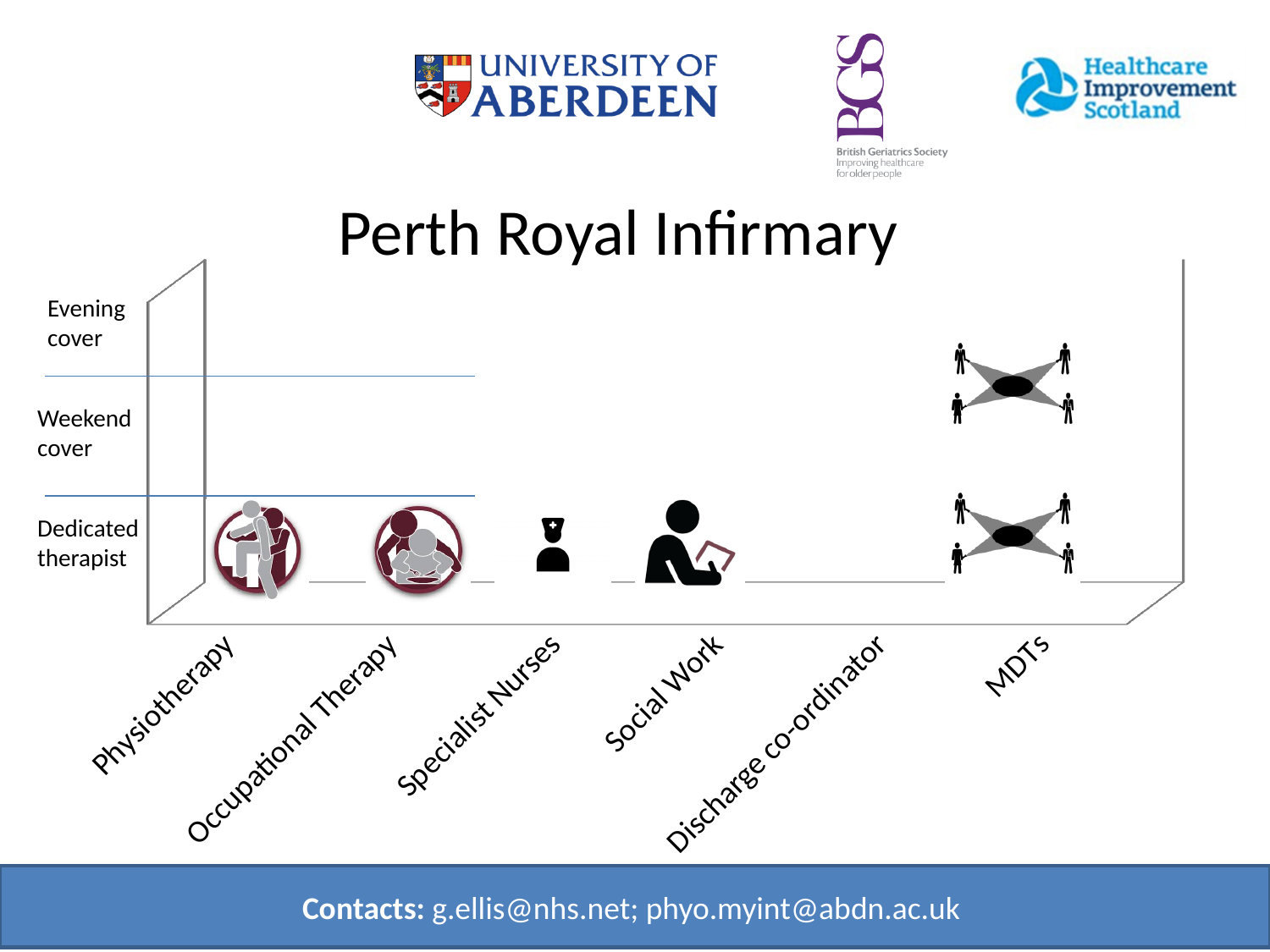
What is the label of the lowest level on the y axis? Dedicated therapist What is the title of the chart? Perth Royal Infirmary How many levels of cover are labelled on the y axis of the chart? 3 Does any category have an icon at the Evening cover level? No How many categories are shown along the x axis of the chart? 6 Which category is the only one with an icon at the Weekend cover level? MDTs What is the label of the first category on the x axis? Physiotherapy At which level is the icon for Social Work placed? Dedicated therapist Which reaches a higher level of cover, Specialist Nurses or MDTs? MDTs At which level is the icon for Physiotherapy placed? Dedicated therapist Which category has no icon at any level of the chart? Discharge co-ordinator What is the label of the highest level on the y axis? Evening cover